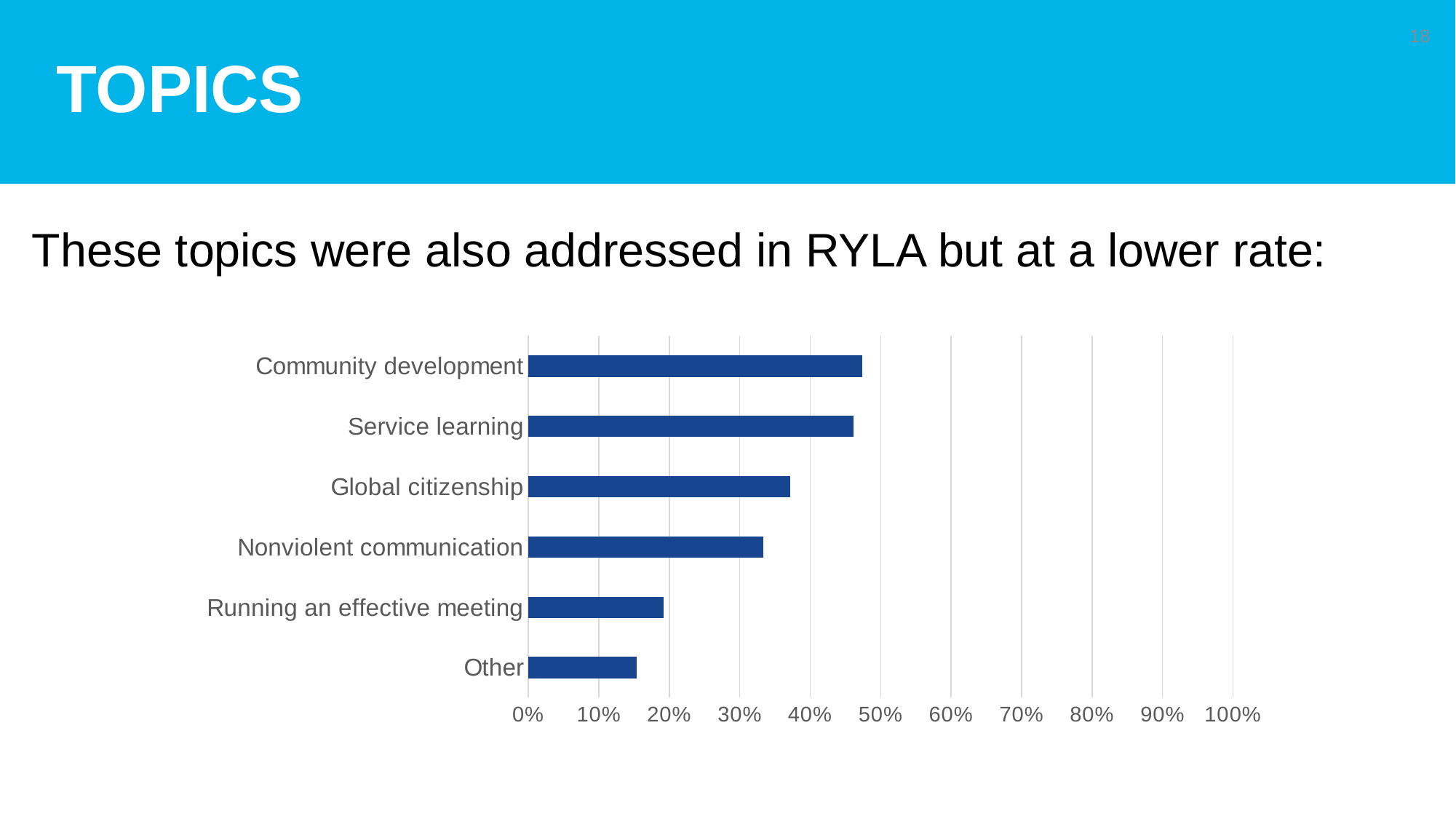
What kind of chart is shown on the slide? bar chart Is the value for Nonviolent communication greater or less than 30%? greater Which is larger, the value for Running an effective meeting or the value for Other? Running an effective meeting Is the value for Community development greater or less than 40%? greater How many topics are plotted in the chart? 6 Is the value for Global citizenship greater or less than 40%? less Do the bar values increase or decrease going from the top category to the bottom category? decrease Which is larger, the value for Global citizenship or the value for Nonviolent communication? Global citizenship Which topic has the lowest value in the chart? Other What is the highest value shown on the horizontal axis of the chart? 100%